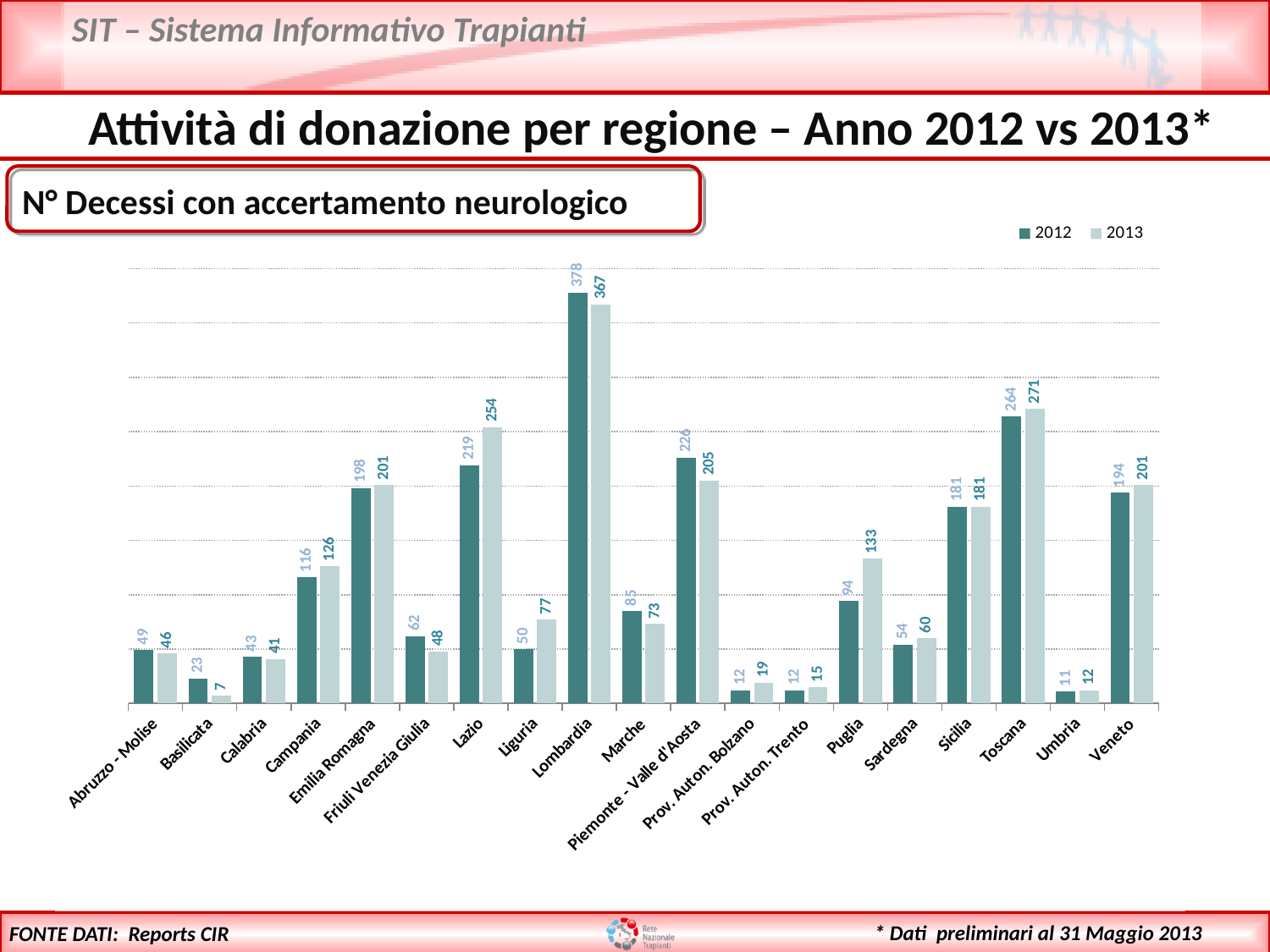
Which region has the highest 2013 value? Lombardia What is the 2012 value for Lombardia? 378 What is the 2013 value for Lazio? 254 How many regions are shown on the x axis? 19 What is the difference between the 2012 and 2013 values for Basilicata? 16 Which is larger for Liguria, the 2012 value or the 2013 value? 2013 How many series does the legend list? 2 What is the difference between the 2013 values for Toscana and Lazio? 17 What is the title shown in the box above the chart? N° Decessi con accertamento neurologico What kind of chart is shown on the slide? Bar chart Which region has the lowest 2013 value? Basilicata What is the 2013 value for Puglia? 133